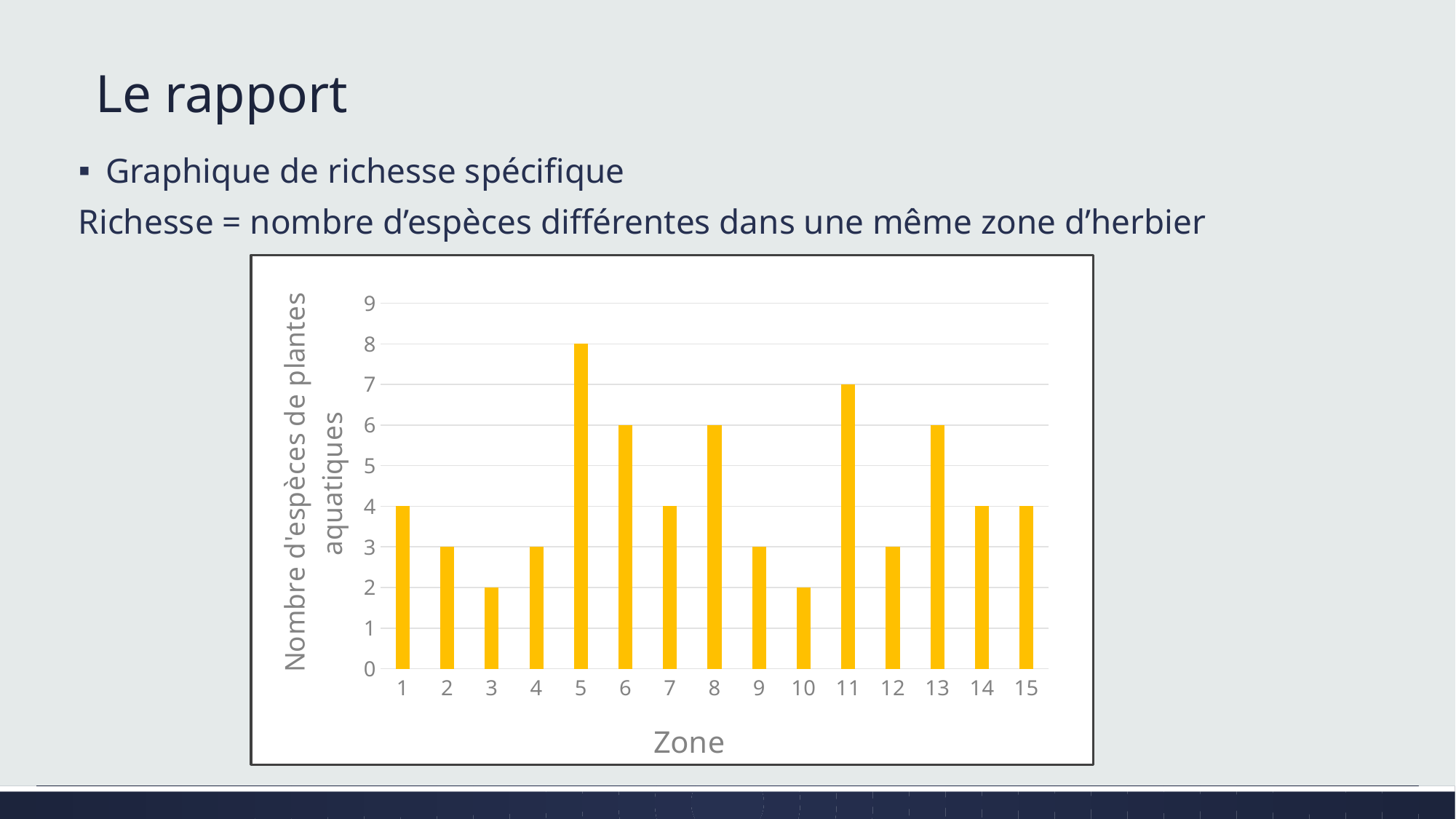
Which zones have the lowest number of aquatic plant species? Zones 3 and 10 How many zones are plotted on the x axis of the chart? 15 Which zone has the highest number of aquatic plant species? Zone 5 What type of chart is shown on the slide? bar chart What is the number of aquatic plant species in zone 5? 8 Which zone has more aquatic plant species, zone 6 or zone 7? Zone 6 What is the number of aquatic plant species in zone 11? 7 What is the number of aquatic plant species in zone 1? 4 What is the number of aquatic plant species in zone 10? 2 What is the difference between the number of species in zone 5 and zone 11? 1 What is the title of the x axis of the chart? Zone What is the title of the y axis of the chart? Nombre d'espèces de plantes aquatiques